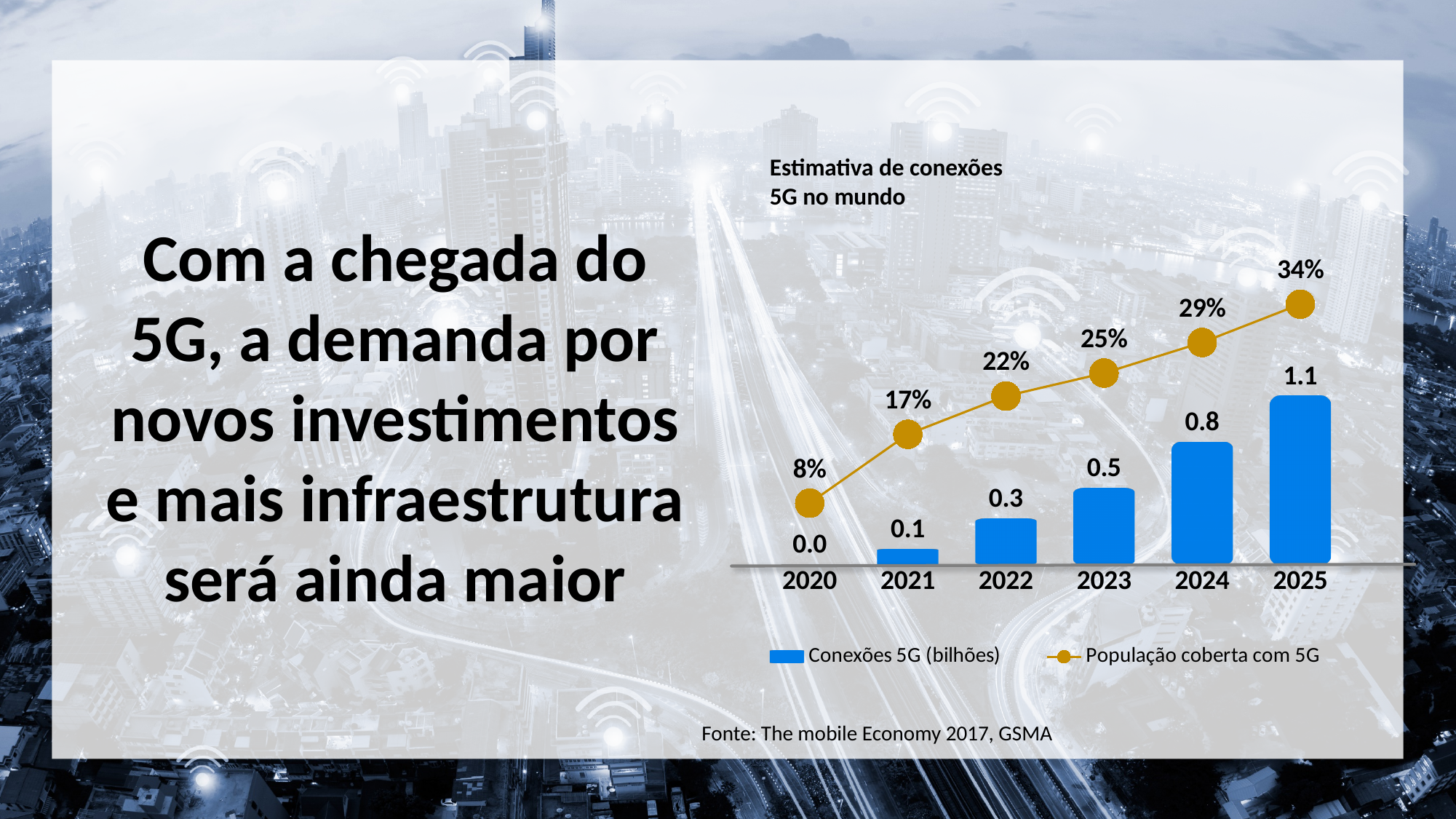
Do the Conexões 5G (bilhões) values rise or fall from 2020 to 2025? Rise What is the value of Conexões 5G (bilhões) for 2025? 1.1 What is the difference between the População coberta com 5G values for 2025 and 2020? 26% How many years are shown on the x axis of the chart? 6 How many series does the legend list? 2 Which is larger, the Conexões 5G (bilhões) value for 2021 or for 2024? 2024 What is the value of Conexões 5G (bilhões) for 2023? 0.5 Which year has the highest value for População coberta com 5G? 2025 Which year has the lowest value for Conexões 5G (bilhões)? 2020 What is the value of População coberta com 5G for 2022? 22% What kind of chart is shown on the slide? Combined bar and line chart What is the difference between the Conexões 5G (bilhões) values for 2024 and 2022? 0.5